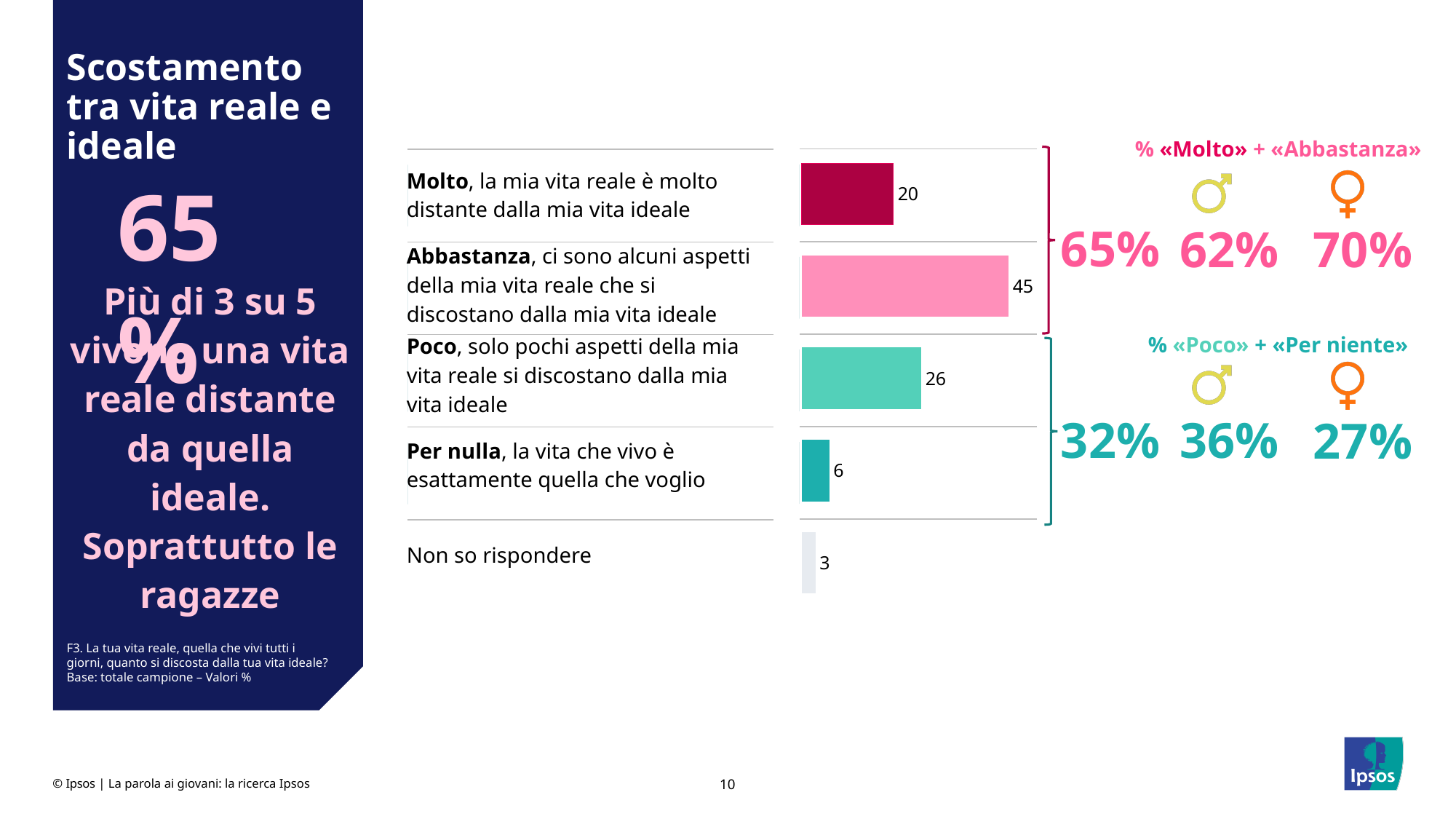
What is the difference between the values for "Abbastanza" and "Molto"? 25 What is the value for "Per nulla" in the bar chart? 6 What is the value for "Abbastanza" in the bar chart? 45 Which is larger, the value for "Poco" or the value for "Molto"? Poco Which category has the highest value in the bar chart? Abbastanza What is the value for "Poco" in the bar chart? 26 What is the value for "Molto" in the bar chart? 20 How many categories are shown in the bar chart? 5 What is the value for "Non so rispondere" in the bar chart? 3 What is the combined percentage of "Molto" and "Abbastanza" shown for females (♀)? 70% What kind of chart is shown on the slide? Bar chart Which category has the lowest value in the bar chart? Non so rispondere